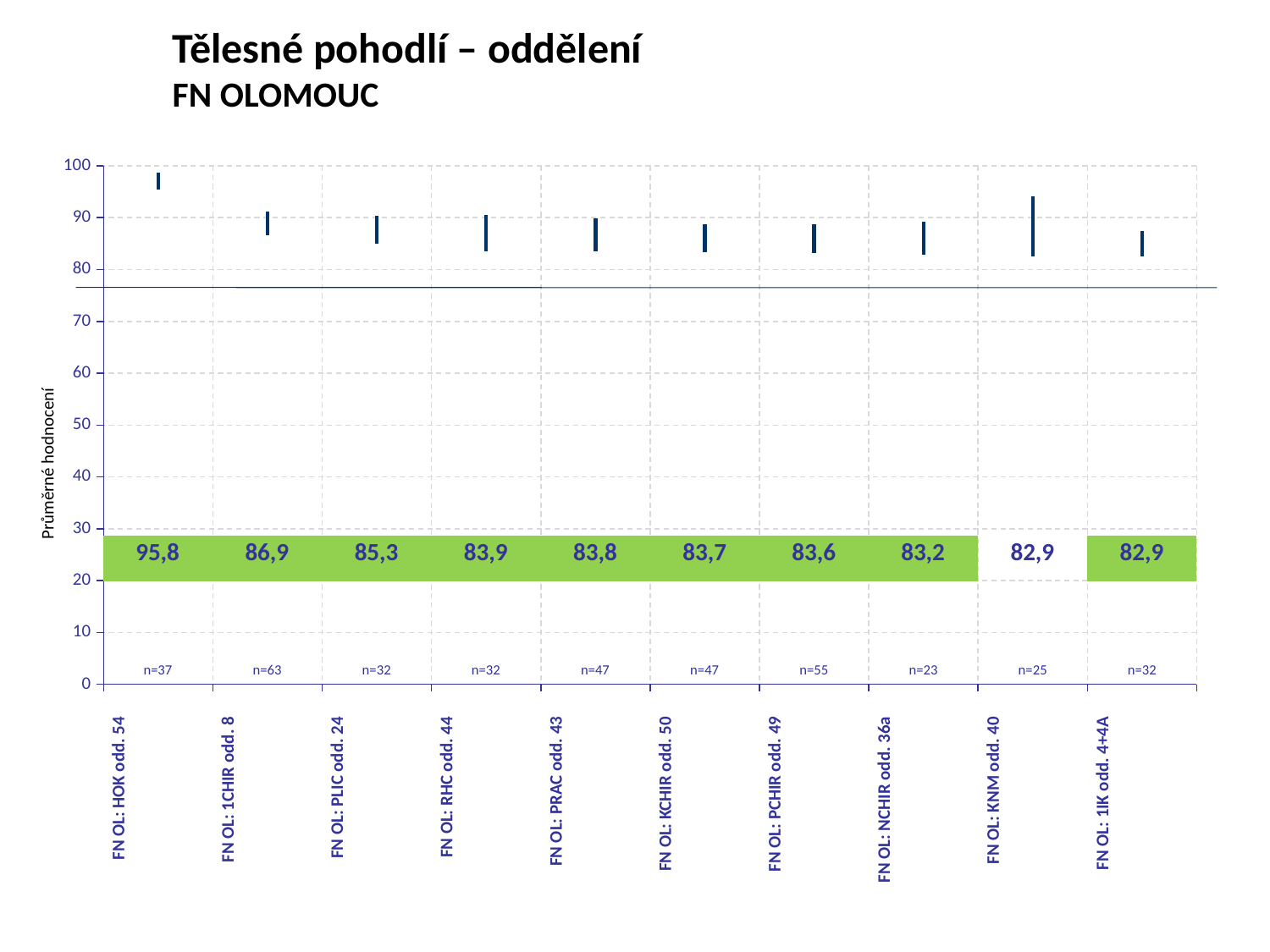
Is the value for FN OL: HOK odd. 54 greater or less than 90? greater What is the value for FN OL: NCHIR odd. 36a? 83,2 How many departments are shown on the x axis? 10 Do the values rise or fall from left to right along the x axis? fall What is the difference between the values for FN OL: 1CHIR odd. 8 and FN OL: PLIC odd. 24? 1,6 What is the sample size (n) shown for FN OL: 1CHIR odd. 8? n=63 What is the value for FN OL: PLIC odd. 24? 85,3 Which department has the highest value? FN OL: HOK odd. 54 What is the value for FN OL: HOK odd. 54? 95,8 Which is larger, the value for FN OL: PLIC odd. 24 or FN OL: KNM odd. 40? FN OL: PLIC odd. 24 What is the label of the y axis? Průměrné hodnocení What is the difference between the values for FN OL: HOK odd. 54 and FN OL: 1CHIR odd. 8? 8,9